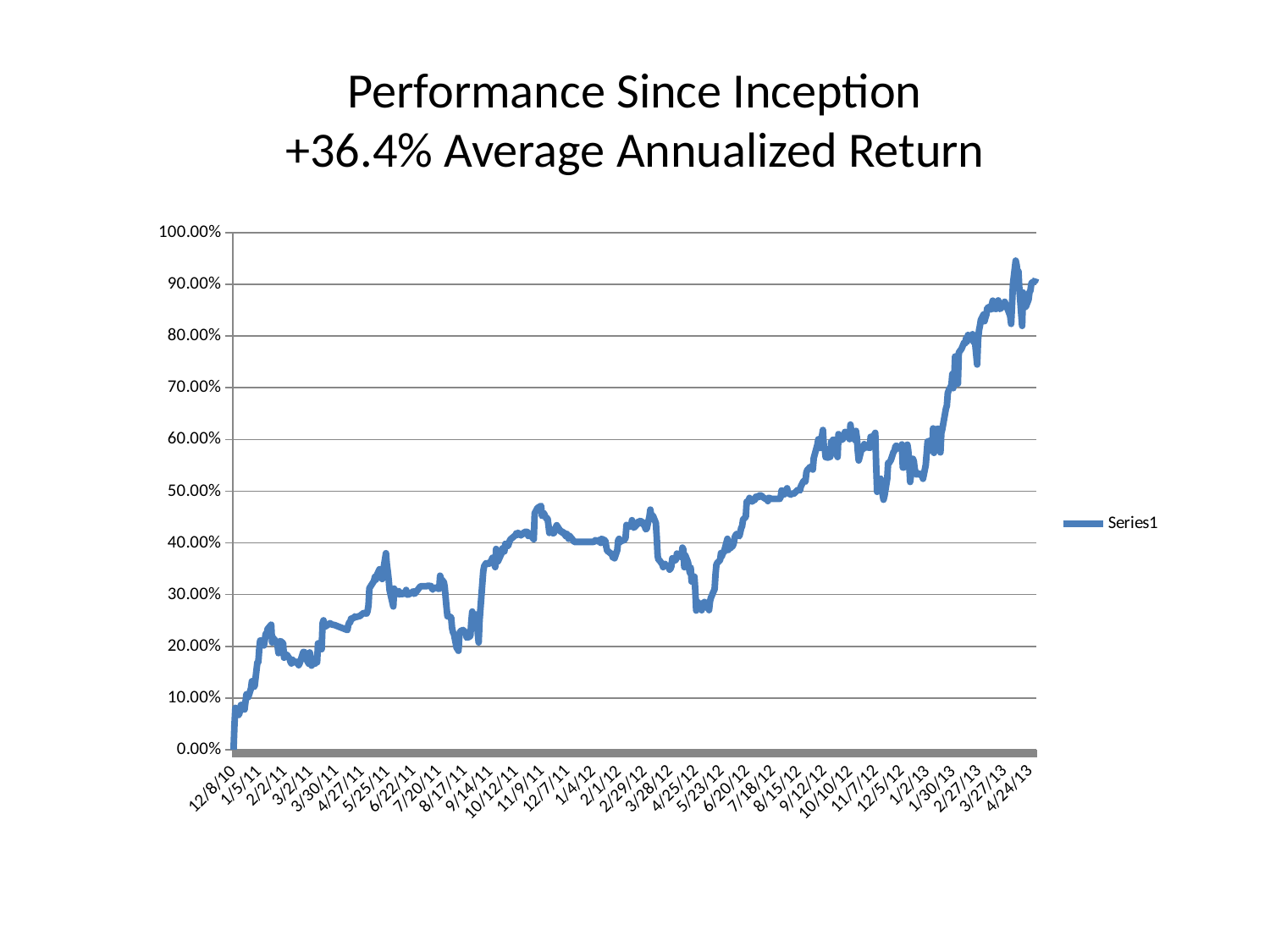
Overall, do the values rise or fall from 12/8/10 to 4/24/13? rise Is the value at 5/23/12 greater or less than 40.00%? less What average annualized return does the chart title state? +36.4% Is the value at 4/24/13 greater or less than 80.00%? greater Is the value at 8/17/11 greater or less than 40.00%? less What is the value at the first date, 12/8/10? 0.00% What is the name of the series shown in the legend? Series1 What kind of chart is shown on the slide? line chart How many series does the legend list? 1 Which is larger, the value at 9/12/12 or the value at 5/23/12? 9/12/12